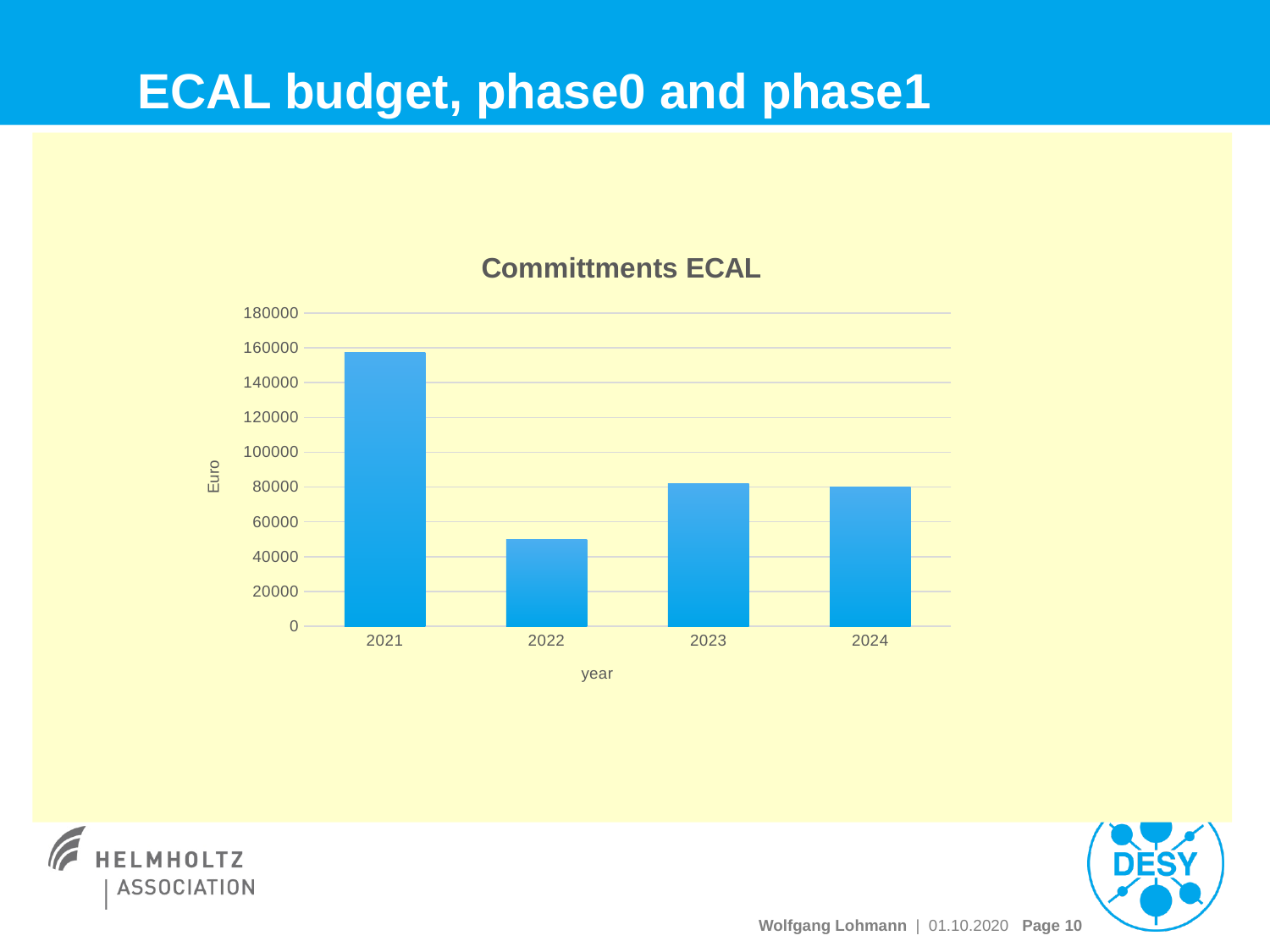
Which year has the highest commitment value? 2021 What kind of chart is shown on the slide? bar chart What is the title of the chart? Committments ECAL Which year has the larger value, 2022 or 2024? 2024 Does the value rise or fall from 2021 to 2022? fall Is the value for 2023 greater or less than 60000? greater How many years are shown on the x axis of the chart? 4 Which year has the larger value, 2021 or 2023? 2021 Which year has the lowest commitment value? 2022 Is the value for 2021 greater or less than 140000? greater Is the value for 2022 greater or less than 60000? less